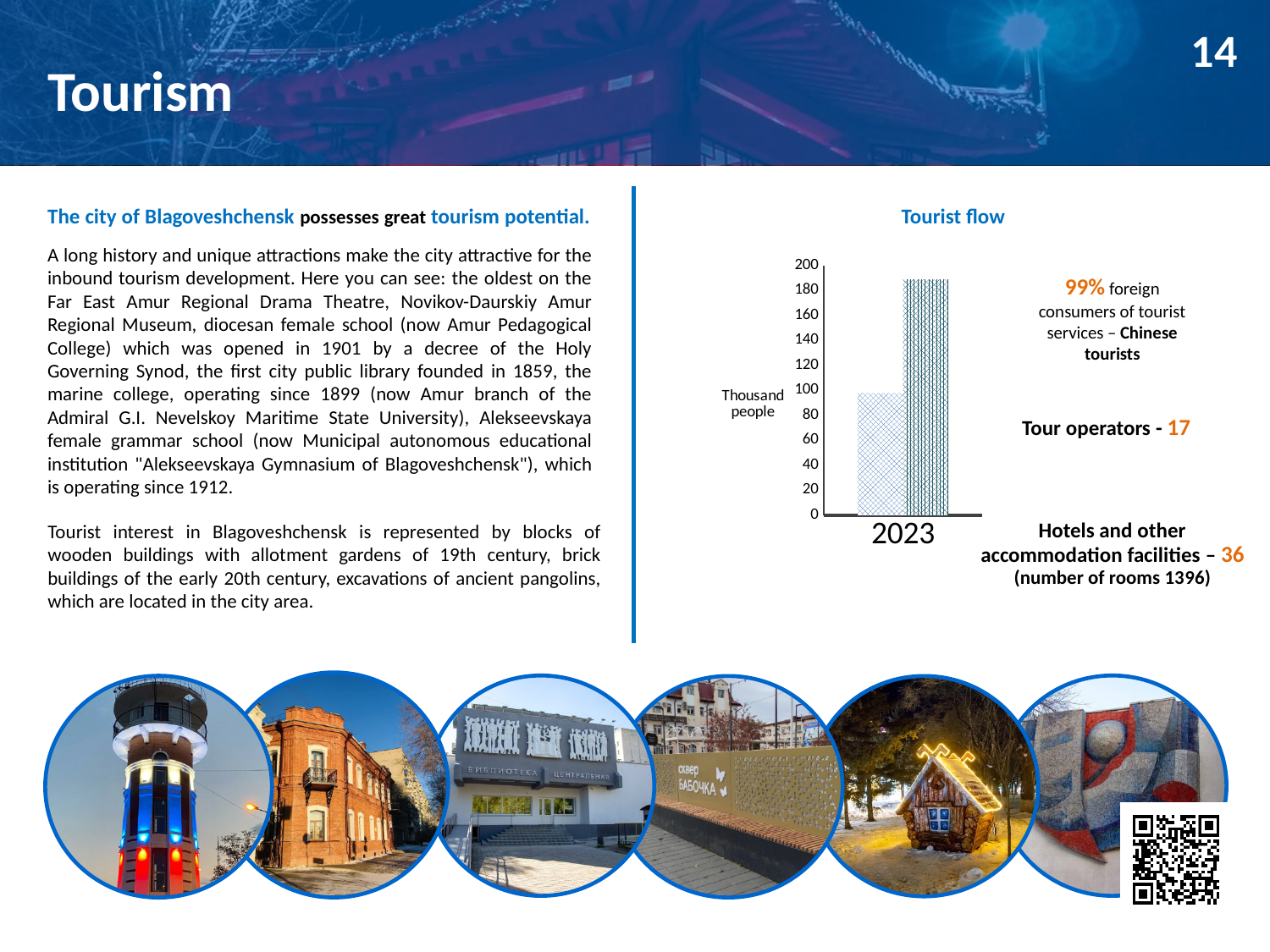
In the Tourist flow chart, is the value of the right bar for 2023 greater or less than 180? greater What is the title of the chart on the right side of the slide? Tourist flow Which year is labelled on the x axis of the Tourist flow chart? 2023 What kind of chart is shown under the title "Tourist flow"? bar chart How many bars are plotted in the Tourist flow chart? 2 In the Tourist flow chart, which bar for 2023 is taller, the left one or the right one? the right one In the Tourist flow chart, is the value of the right bar for 2023 greater or less than 200? less How many categories are shown on the x axis of the Tourist flow chart? 1 What is the highest tick value shown on the y axis of the Tourist flow chart? 200 In the Tourist flow chart, is the value of the left bar for 2023 greater or less than 80? greater